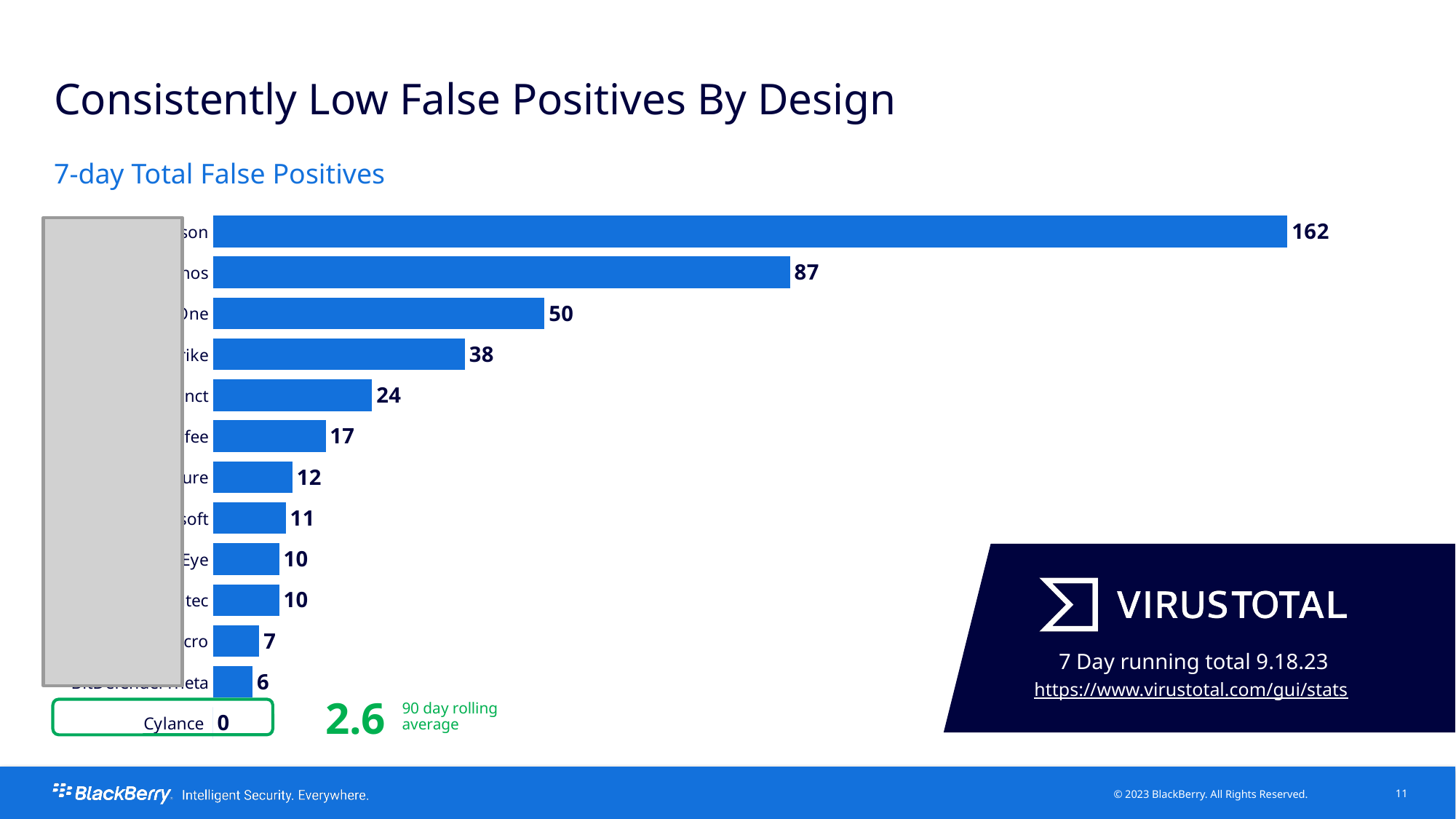
What kind of chart is used to show the 7-day Total False Positives? Bar chart What is the second-highest value shown in the 7-day Total False Positives chart? 87 How many bars in the chart have a value of exactly 10? 2 Which category has the lowest value in the 7-day Total False Positives chart? Cylance What is the lowest non-zero value shown in the chart? 6 What is the difference between the highest value in the chart and the value for Cylance? 162 How many bars are shown in the 7-day Total False Positives chart? 13 What is the highest value shown in the 7-day Total False Positives chart? 162 What is the difference between the highest value (162) and the second-highest value (87) in the chart? 75 What 90 day rolling average is shown next to the Cylance bar? 2.6 What is the 7-day total false positives value shown for Cylance? 0 What is the title of the chart on the slide? 7-day Total False Positives